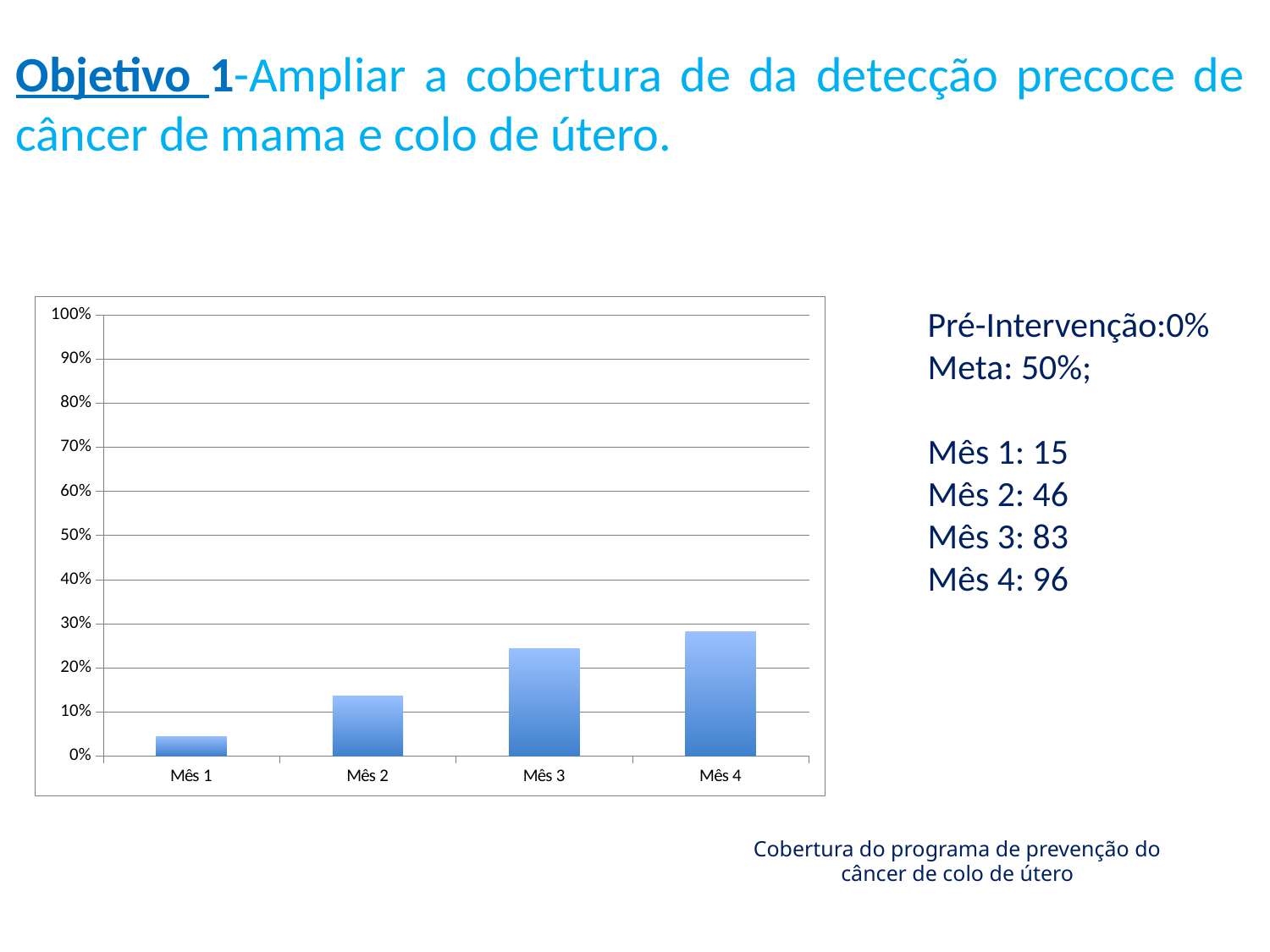
What is the maximum value shown on the chart's vertical axis? 100% Which month has the highest bar on the chart? Mês 4 Which is larger, the value for Mês 2 or the value for Mês 3? Mês 3 Is the value for Mês 1 greater or less than 10%? less Is the value for Mês 2 greater or less than 20%? less Is the value for Mês 3 greater or less than 20%? greater What kind of chart is shown on the slide? bar chart Do the bar values rise or fall from Mês 1 to Mês 4? rise How many categories (months) are plotted on the chart? 4 Which month has the lowest bar on the chart? Mês 1